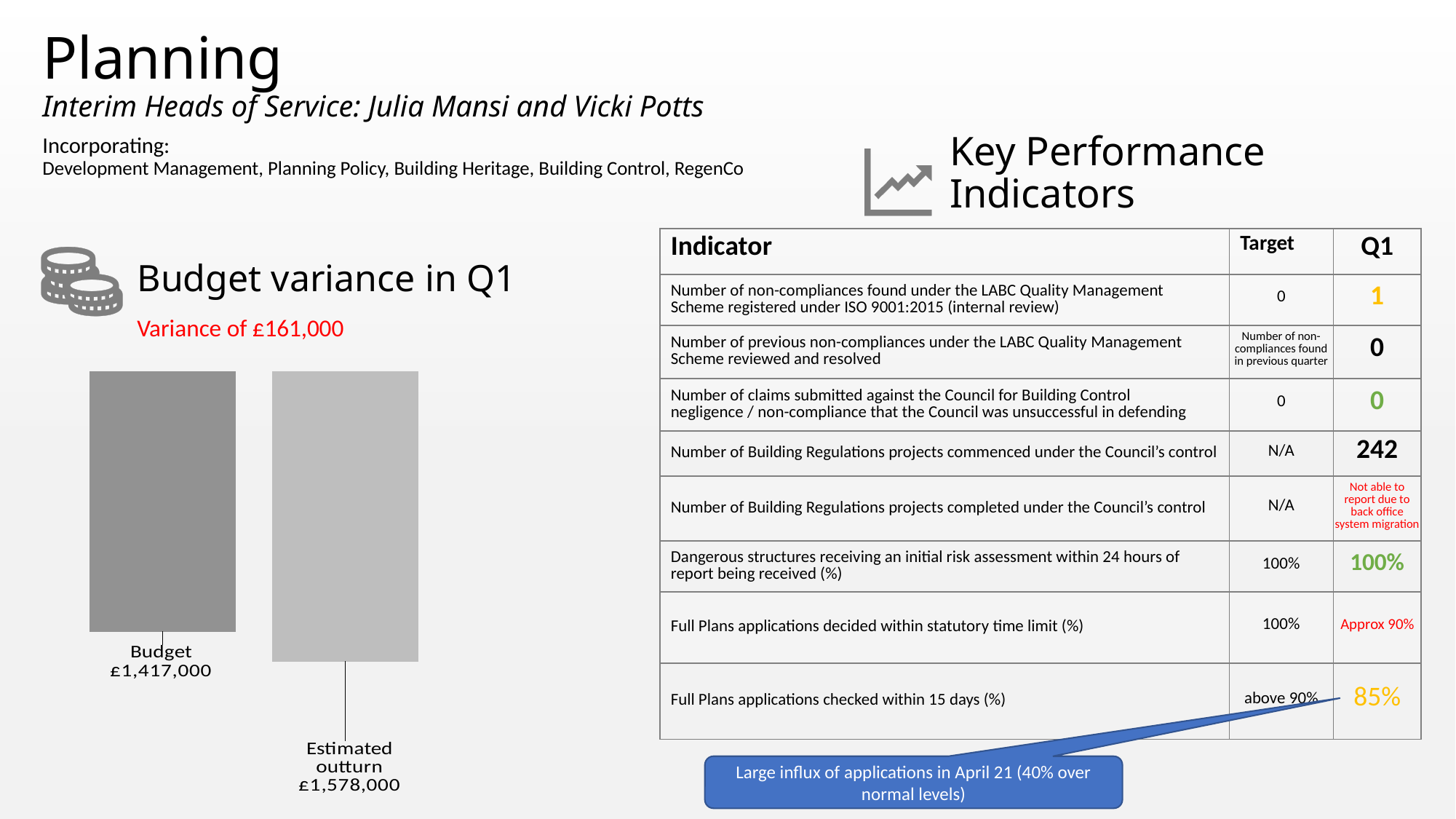
How many bars does the 'Budget variance in Q1' chart show? 2 Do the values rise or fall from the Budget bar to the Estimated outturn bar in the 'Budget variance in Q1' chart? rise What is the value of the Estimated outturn bar in the 'Budget variance in Q1' chart? £1,578,000 What kind of chart is shown under 'Budget variance in Q1'? bar chart What is the title of the chart on the left of the slide? Budget variance in Q1 What is the difference between the Estimated outturn and the Budget in the 'Budget variance in Q1' chart? £161,000 What variance is stated above the 'Budget variance in Q1' chart? Variance of £161,000 What is the value of the Budget bar in the 'Budget variance in Q1' chart? £1,417,000 Which bar is taller in the 'Budget variance in Q1' chart, Budget or Estimated outturn? Estimated outturn Which category has the highest value in the 'Budget variance in Q1' chart? Estimated outturn Which category has the lowest value in the 'Budget variance in Q1' chart? Budget